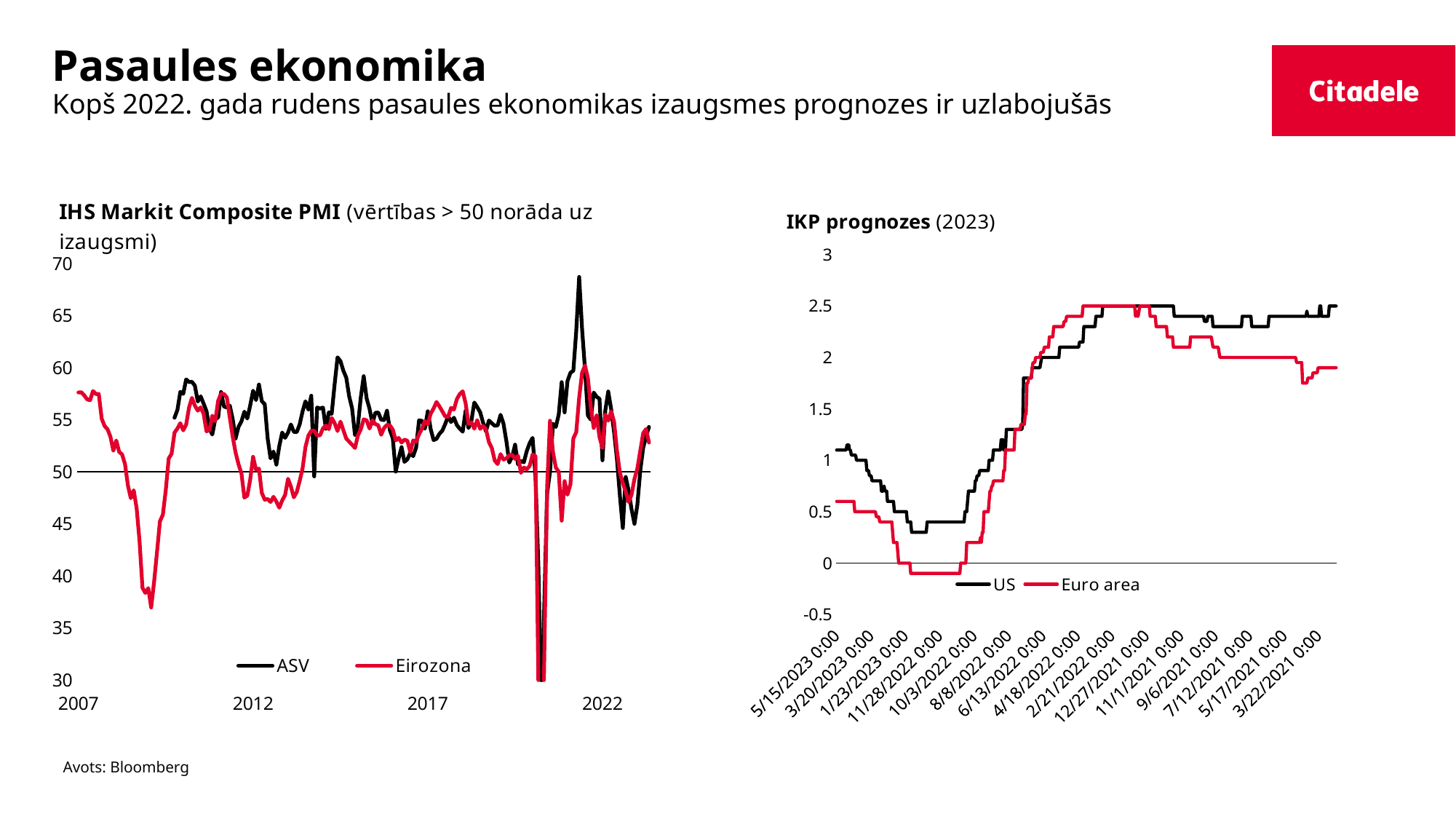
In the IKP prognozes (2023) chart, which series is higher at 3/22/2021, US or Euro area? US In the IHS Markit Composite PMI chart, is the highest value of the ASV line greater or less than 65? greater What kind of chart is the IHS Markit Composite PMI chart on the left? line chart In the IHS Markit Composite PMI chart, is the lowest value of the Eirozona line in 2020 greater or less than 35? less What source is cited at the bottom of the slide for the charts? Bloomberg In the IKP prognozes (2023) chart, is the lowest value of the Euro area line greater or less than 0? less How many series does the legend of the IHS Markit Composite PMI chart list? 2 In the IHS Markit Composite PMI chart, which series reaches the higher peak around 2021, ASV or Eirozona? ASV What kind of chart is the IKP prognozes (2023) chart on the right? line chart How many series does the legend of the IKP prognozes (2023) chart list? 2